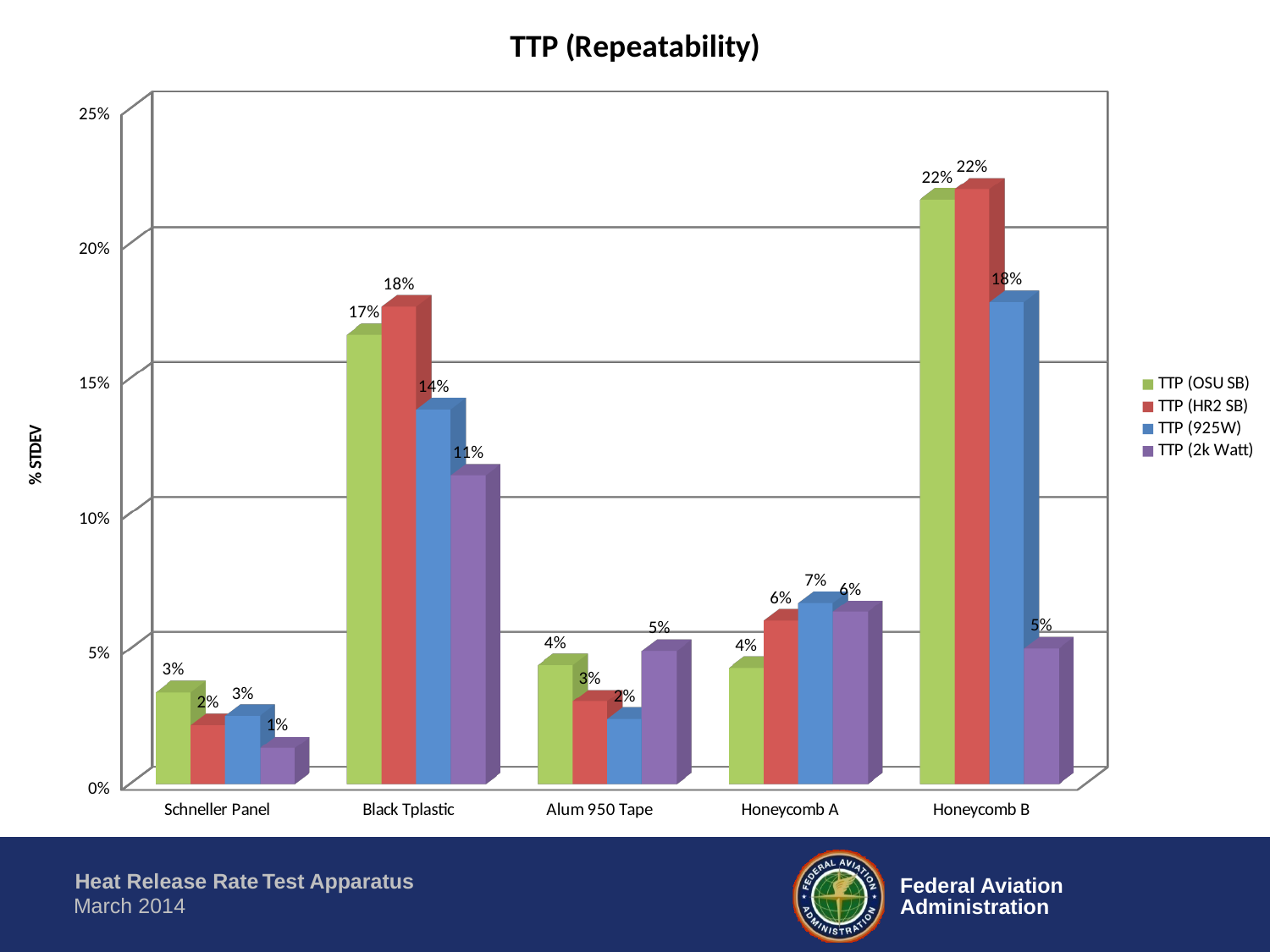
What is the title of the chart? TTP (Repeatability) Is the TTP (OSU SB) value for Honeycomb B greater or less than 20%? greater How many series does the legend list? 4 Which category has the highest TTP (HR2 SB) value? Honeycomb B What is the TTP (925W) value for Black Tplastic? 14% What is the TTP (OSU SB) value for Alum 950 Tape? 4% Which category has the lowest TTP (2k Watt) value? Schneller Panel What is the TTP (2k Watt) value for Honeycomb B? 5% How many categories are shown on the x axis? 5 Which is larger for Black Tplastic: TTP (OSU SB) or TTP (2k Watt)? TTP (OSU SB) What is the difference between the TTP (HR2 SB) and TTP (925W) values for Honeycomb B? 4% What kind of chart is shown on the slide? bar chart